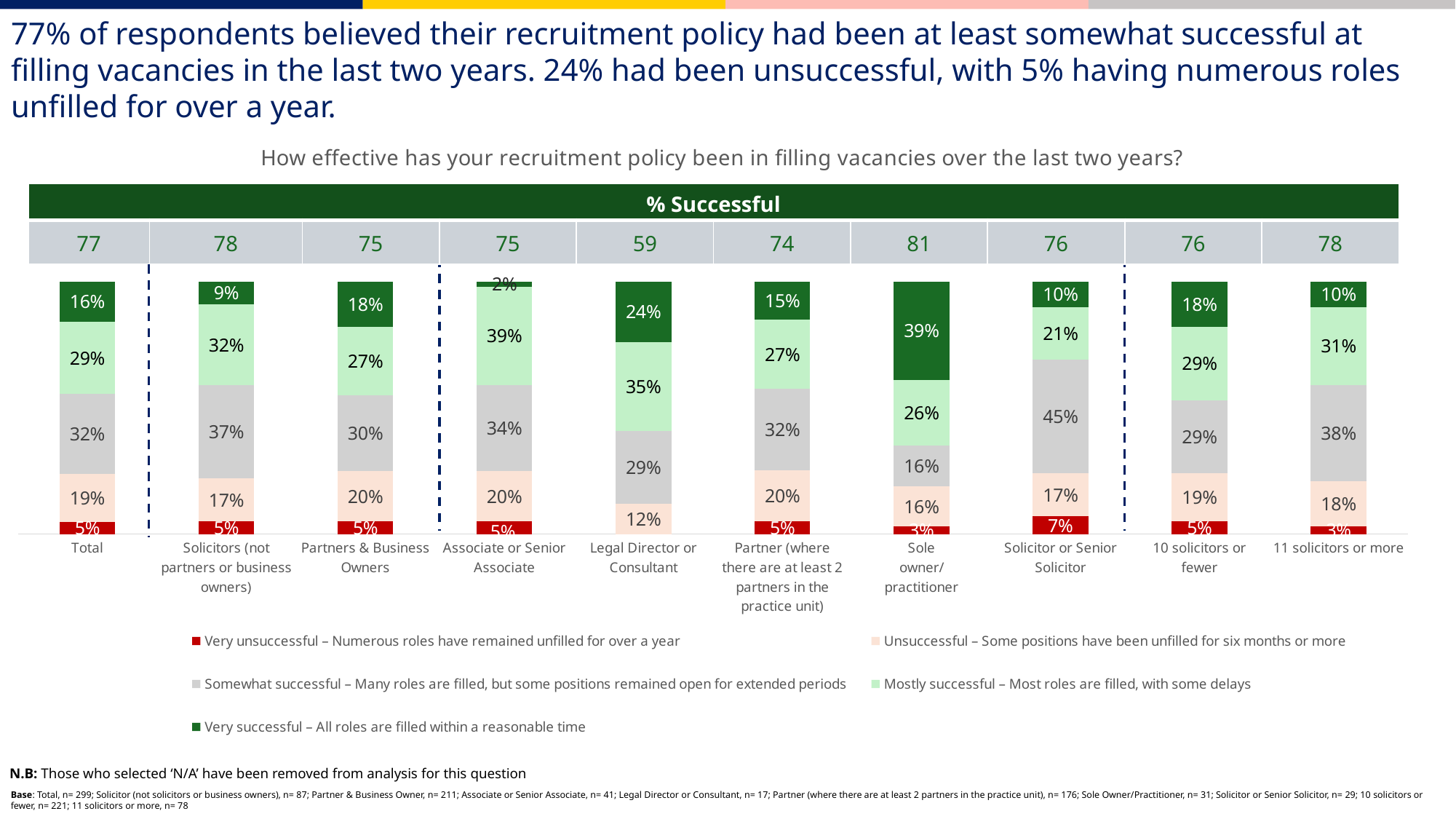
What is the 'Very successful' value for Sole owner/practitioner? 39% What is the 'Very unsuccessful' value for Solicitor or Senior Solicitor? 7% Which category has the lowest '% Successful' figure? Legal Director or Consultant How many categories are shown along the x axis? 10 What kind of chart is shown on the slide? Stacked bar chart How many series does the legend list? 5 What is the 'Unsuccessful' value for Legal Director or Consultant? 12% Which category has the highest '% Successful' figure? Sole owner/practitioner Which is larger, the 'Mostly successful' value for Associate or Senior Associate or for 11 solicitors or more? Associate or Senior Associate What is the 'Somewhat successful' value for Solicitor or Senior Solicitor? 45% What is the '% Successful' figure for Partners & Business Owners? 75 What is the difference between the 'Very successful' values for Legal Director or Consultant and Total? 8%